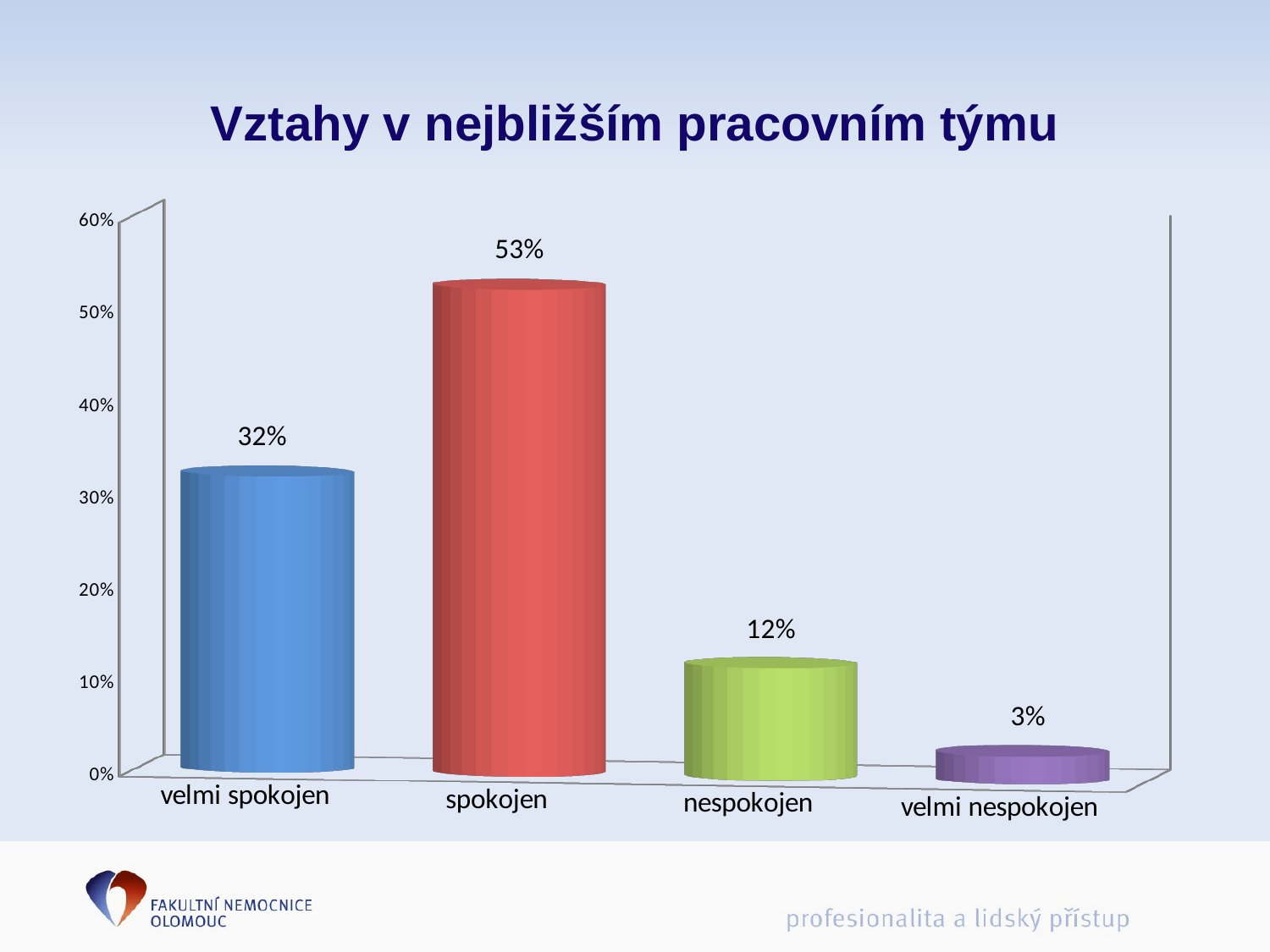
Which category has the lowest value? velmi nespokojen What is the value for "spokojen"? 53% Which is larger, the value for "velmi spokojen" or the value for "nespokojen"? velmi spokojen How many categories are shown on the x axis? 4 What is the value for "velmi spokojen"? 32% What is the difference between the values for "spokojen" and "velmi spokojen"? 21% What is the difference between the values for "nespokojen" and "velmi nespokojen"? 9% What is the title of the chart? Vztahy v nejbližším pracovním týmu What is the value for "velmi nespokojen"? 3% Which category has the highest value? spokojen What kind of chart is shown on the slide? bar chart What is the value for "nespokojen"? 12%